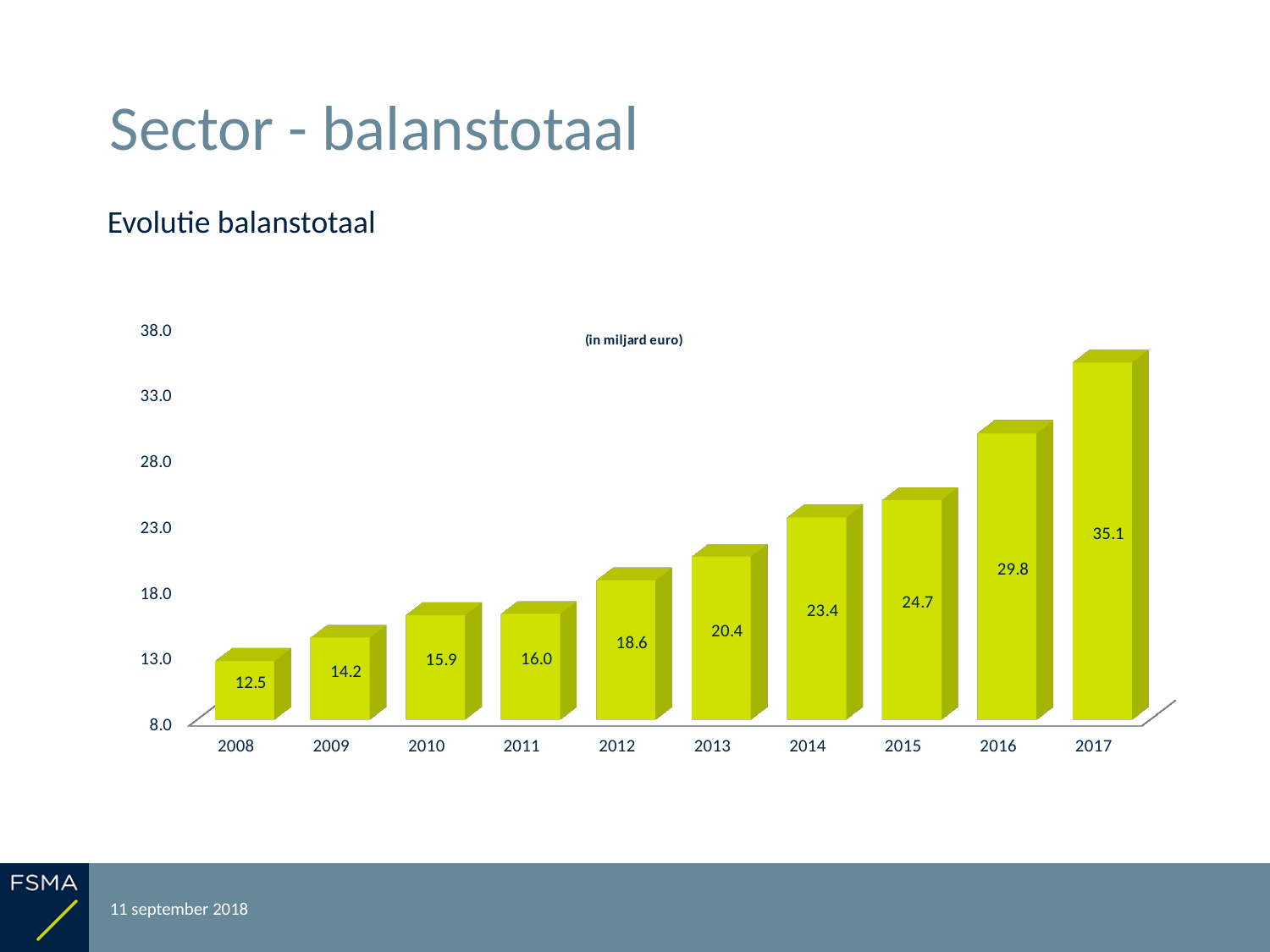
What is the value for 2017? 35.1 Which year has the highest value? 2017 What is the value for 2013? 20.4 How many years are shown on the x axis? 10 What is the value for 2008? 12.5 Is the value for 2015 greater or less than 23.0? greater Which is larger, the value for 2014 or the value for 2011? 2014 What is the difference between the values for 2017 and 2016? 5.3 Which year has the lowest value? 2008 What kind of chart is shown? bar chart Do the values rise or fall from 2008 to 2017? rise What is the difference between the values for 2012 and 2008? 6.1